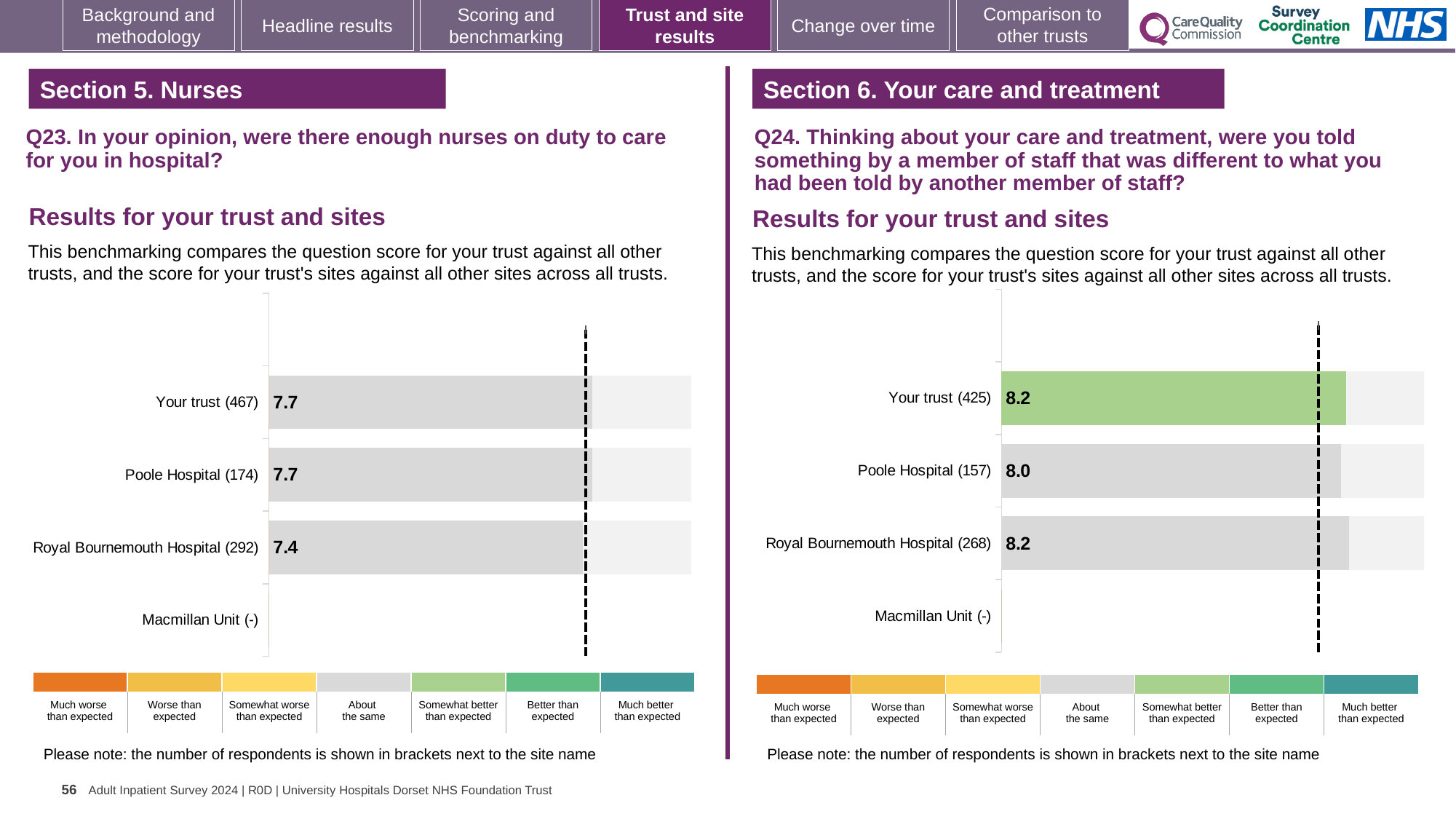
In the Q24 chart on the right, which site has the lowest score? Poole Hospital (157) In the Q24 chart on the right, what is the score for Poole Hospital (157)? 8.0 What kind of chart is the Q24 chart on the right? Bar chart How many categories are listed on the y axis of the Q23 chart on the left? 4 In the Q24 chart on the right, what is the difference between the scores for Your trust (425) and Poole Hospital (157)? 0.2 In the Q24 chart on the right, which is larger: the score for Royal Bournemouth Hospital (268) or Poole Hospital (157)? Royal Bournemouth Hospital (268) In the Q23 chart on the left, what is the score for Your trust (467)? 7.7 In the Q23 chart on the left, what is the score for Royal Bournemouth Hospital (292)? 7.4 In the Q24 chart on the right, which benchmark category does the green colour of the Your trust (425) bar correspond to? Somewhat better than expected In the Q23 chart on the left, what is the difference between the scores for Poole Hospital (174) and Royal Bournemouth Hospital (292)? 0.3 In the Q24 chart on the right, what is the score for Your trust (425)? 8.2 In the Q23 chart on the left, which site has the lowest score? Royal Bournemouth Hospital (292)